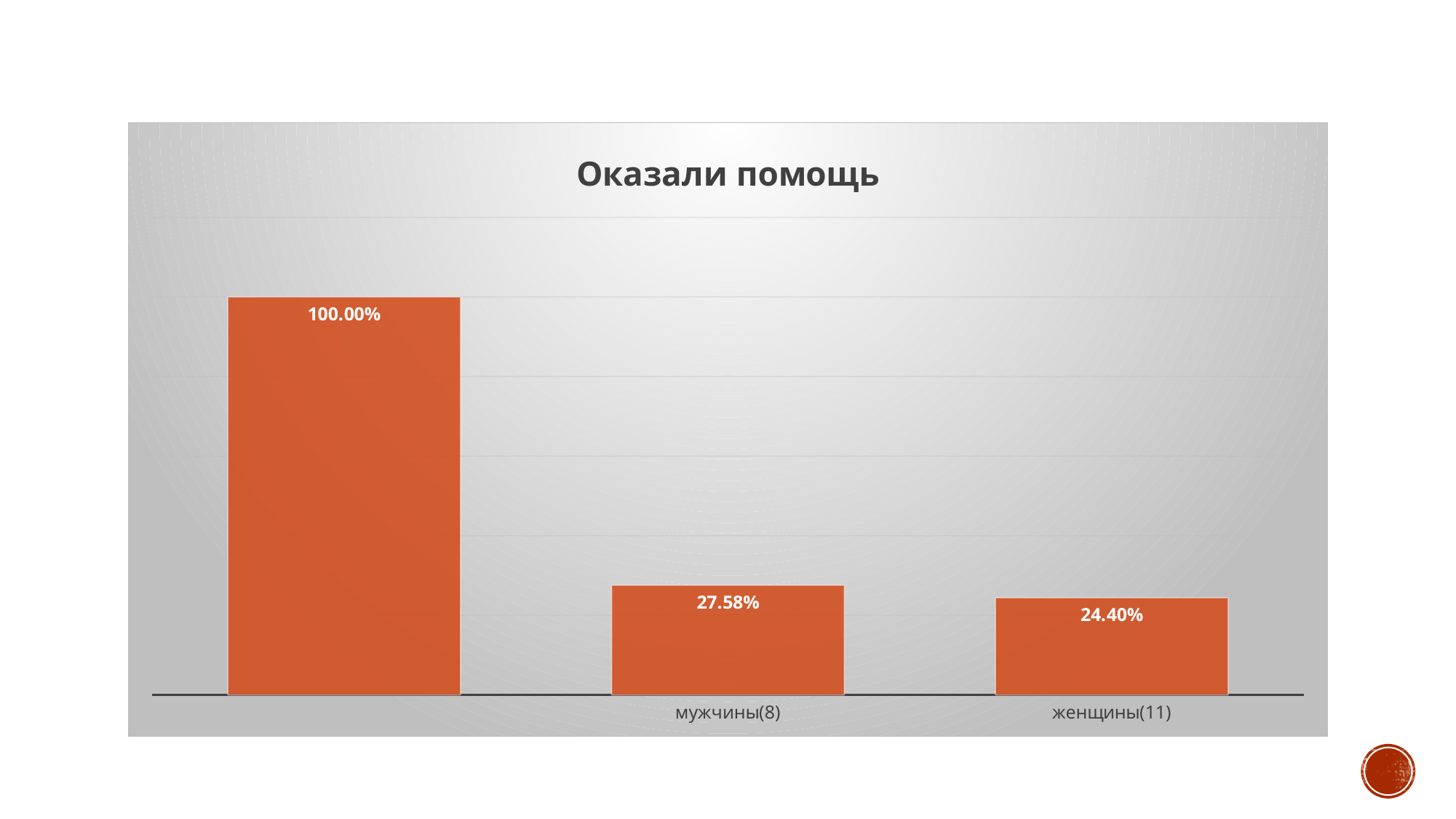
What colour are the bars in the chart? orange What is the value for женщины(11)? 24.40% What type of chart is shown on the slide? bar chart What is the difference between the values for мужчины(8) and женщины(11)? 3.18% What is the title of the chart? Оказали помощь What is the value for мужчины(8)? 27.58% Which is larger, the value for мужчины(8) or the value for женщины(11)? мужчины(8) Which category has the lowest value? женщины(11) How many bars are plotted in the chart? 3 What is the highest value shown on any bar in the chart? 100.00%